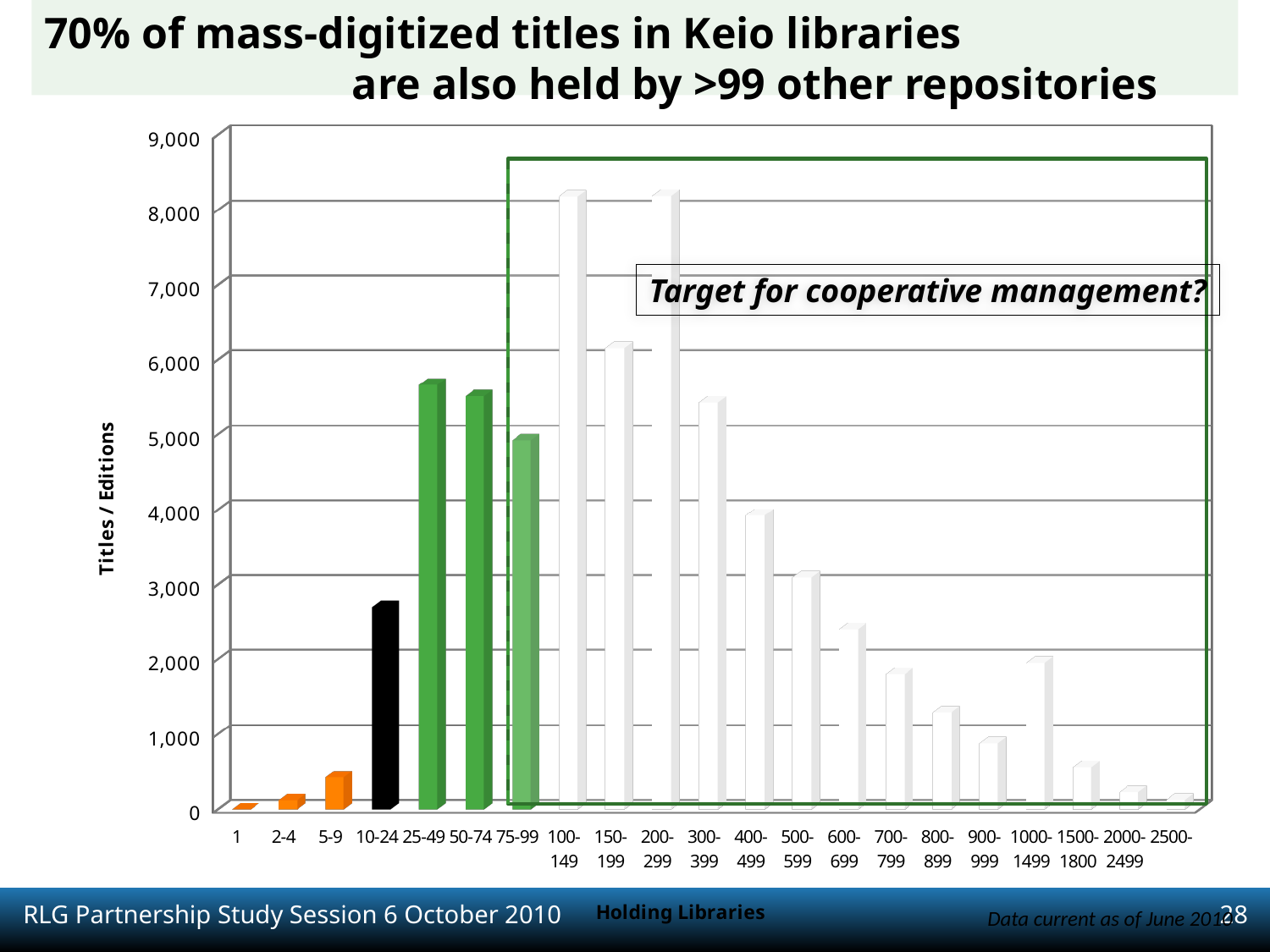
Is the value for the 10-24 category greater or less than 3,000? less What kind of chart is shown on the slide? bar chart How many holding-library categories are plotted along the x axis? 21 Which has the larger value, the 100-149 category or the 150-199 category? 100-149 Is the value for the 150-199 category greater or less than 6,000? greater What is the title of the vertical axis? Titles / Editions Is the value for the 1000-1499 category greater or less than 1,000? greater Do the values rise or fall along the x axis from the 200-299 category to the 900-999 category? fall Which has the larger value, the 1000-1499 category or the 900-999 category? 1000-1499 Which has the larger value, the 25-49 category or the 10-24 category? 25-49